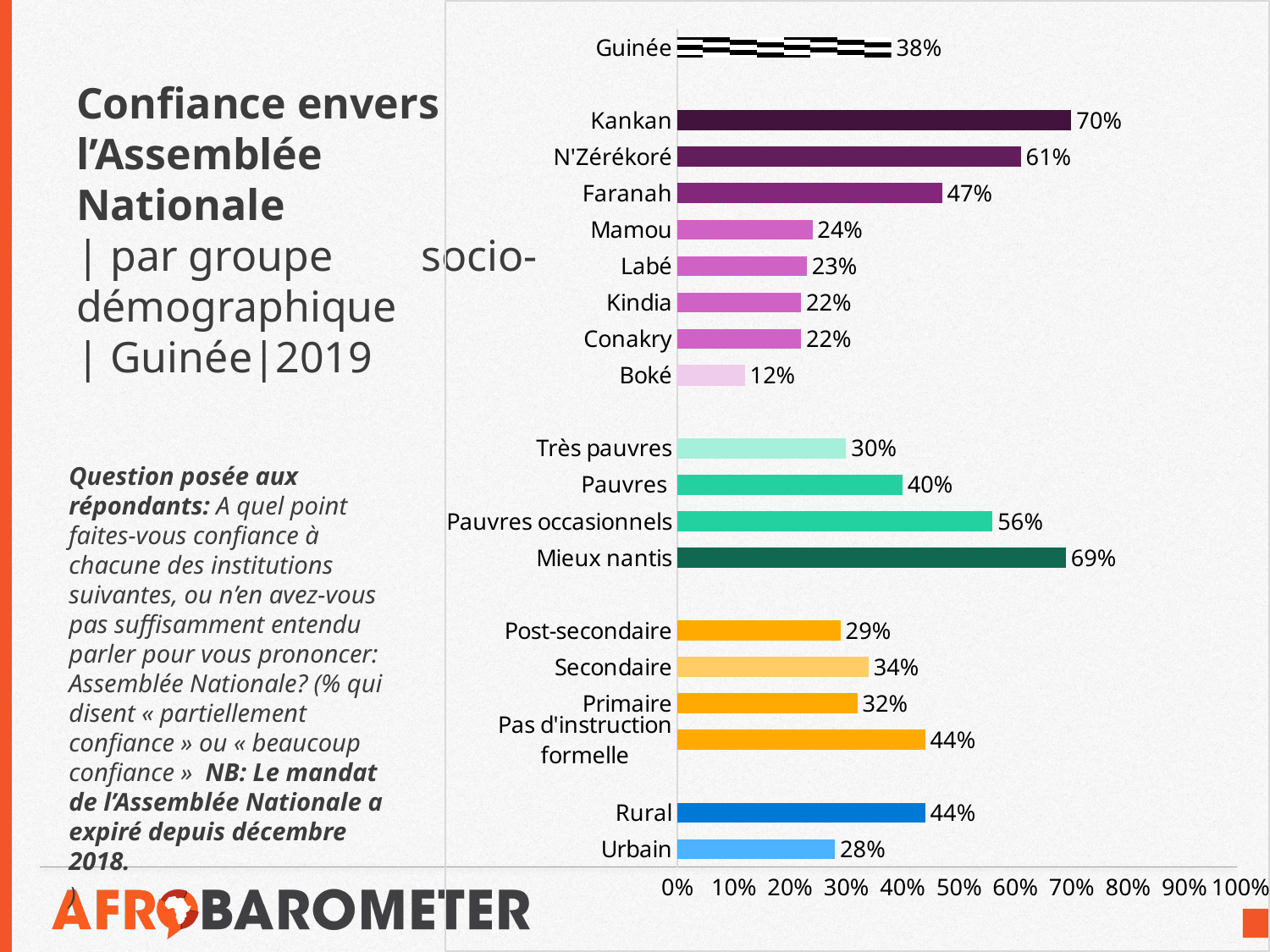
What is the value for Pas d'instruction formelle? 44% What is the difference between Rural and Urbain? 16% What kind of chart is shown on the slide? Bar chart Which region has the highest value? Kankan What is the value for Guinée overall? 38% What is the value for Mieux nantis? 69% Which is larger, Secondaire or Primaire? Secondaire How many bars are shown in the chart? 19 Which region has the lowest value? Boké Is the value for N'Zérékoré greater or less than 50%? greater What is the difference between Mieux nantis and Très pauvres? 39% What is the value for Kankan? 70%